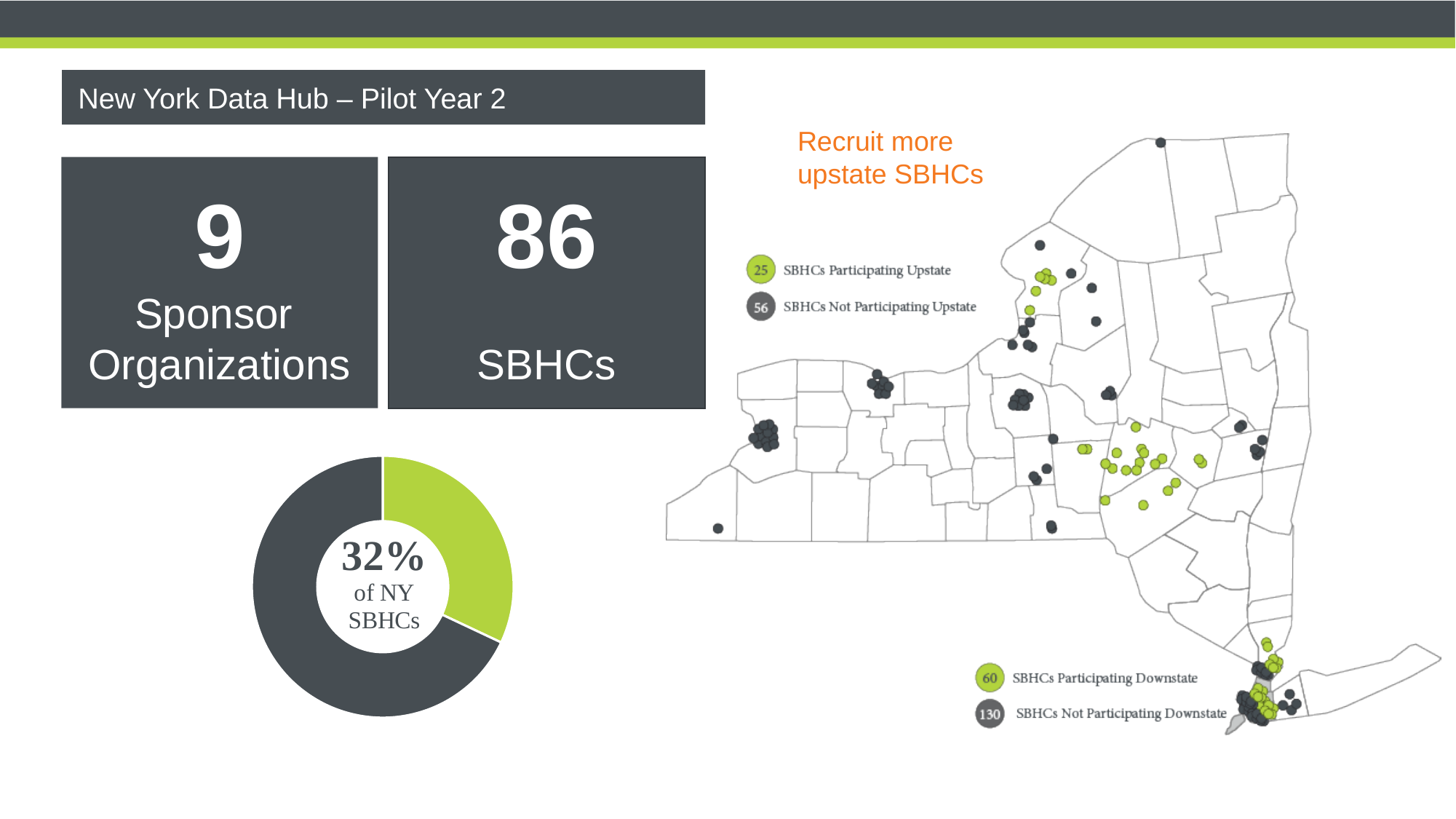
On the map, how many SBHCs are participating upstate according to the legend? 25 In the donut chart, what percentage of NY SBHCs does the green slice represent? 32% On the map legend, what is the difference between the number of SBHCs not participating downstate and the number participating downstate? 70 On the map legend, which category has the smallest count? SBHCs Participating Upstate What kind of chart is shown at the bottom left of the slide? donut chart In the donut chart, which slice is larger, the green slice or the dark grey slice? dark grey On the map, how many SBHCs are participating downstate according to the legend? 60 On the map, how many SBHCs are not participating downstate according to the legend? 130 On the map, how many SBHCs are not participating upstate according to the legend? 56 In the donut chart, is the green slice's share greater or less than 50%? less How many slices does the donut chart have? 2 On the map legend, which category has the largest count? SBHCs Not Participating Downstate